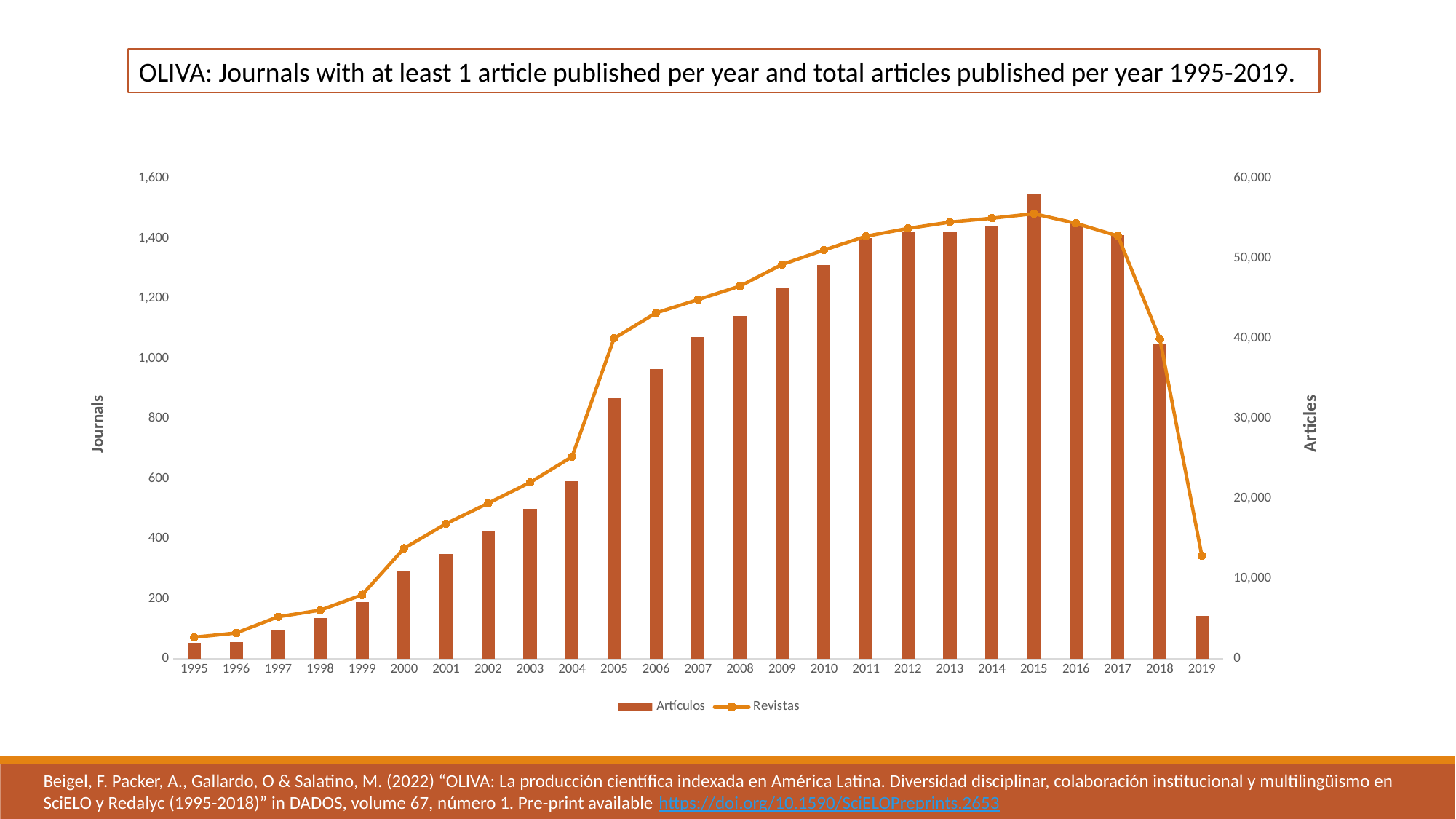
Is the Artículos value for 2019 greater or less than 10,000? less Is the Artículos value for 2003 greater or less than 20,000? less Which year has the highest Artículos bar? 2015 What kind of chart is shown on the slide? A combined bar and line chart What is the label of the left vertical axis? Journals Is the Revistas value for 2019 greater or less than 400? less Does the Revistas line rise or fall from 1995 to 2015? rise Which is larger, the Artículos value for 2015 or for 2019? 2015 How many series does the legend list? 2 How many years are plotted along the x axis? 25